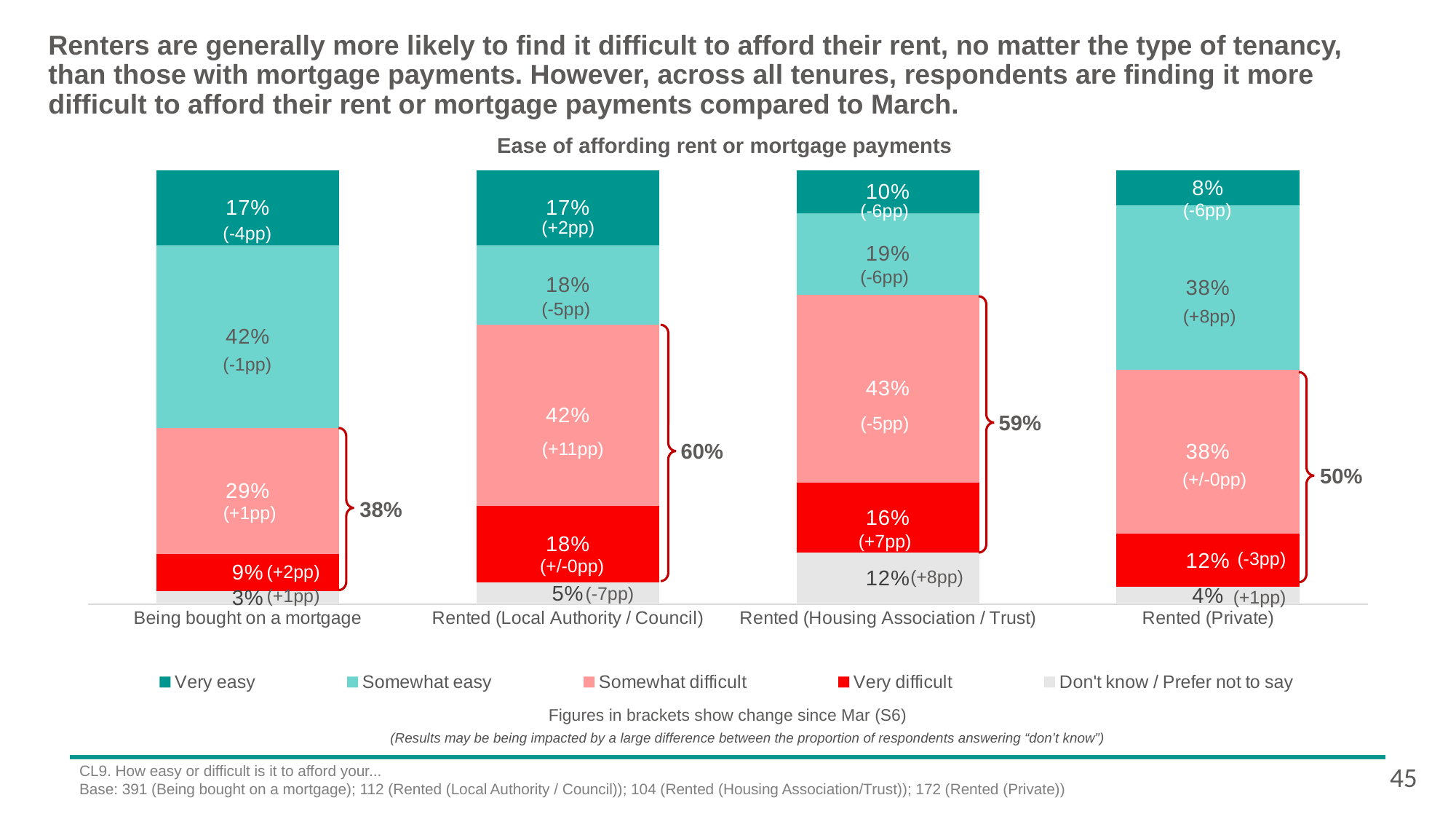
What kind of chart is shown on the slide? Stacked bar chart Which tenure type has the lowest 'Very easy' percentage? Rented (Private) What is the title of the chart? Ease of affording rent or mortgage payments What percentage of respondents in the 'Being bought on a mortgage' category said it was 'Very difficult' to afford their payments? 9% What percentage of 'Rented (Private)' respondents said it was 'Somewhat easy' to afford their payments? 38% What is the difference between the 'Very difficult' values for 'Rented (Housing Association / Trust)' and 'Being bought on a mortgage'? 7 percentage points How many series does the legend list? 5 Which is larger: the 'Somewhat easy' value for 'Being bought on a mortgage' or for 'Rented (Local Authority / Council)'? Being bought on a mortgage What is the combined 'difficult' share shown by the bracket for 'Rented (Local Authority / Council)'? 60% What is the 'Somewhat difficult' value for 'Rented (Housing Association / Trust)'? 43% How many tenure categories are shown on the x axis? 4 Which tenure type has the highest 'Very difficult' percentage? Rented (Local Authority / Council)